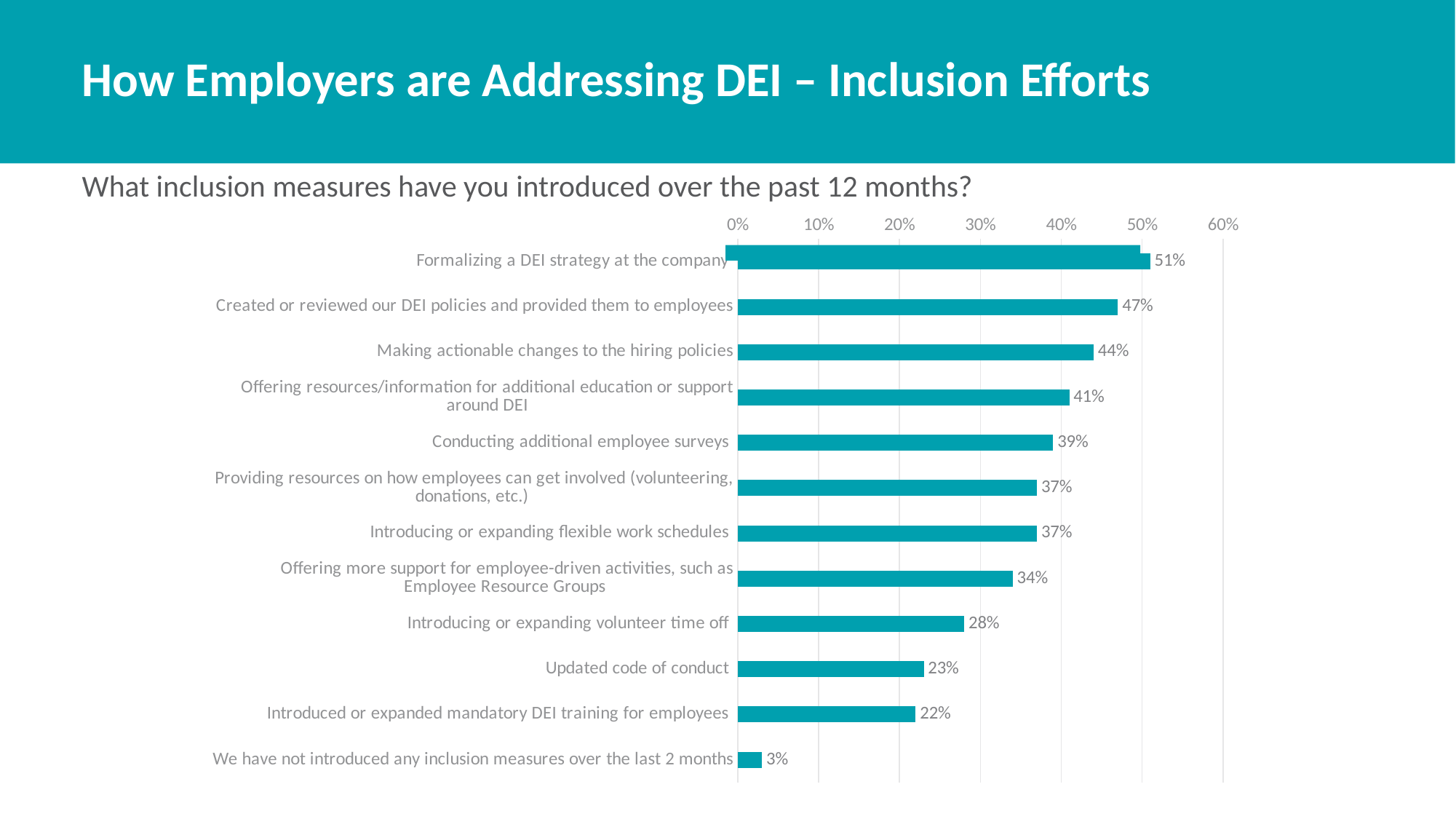
What is the difference between 'Created or reviewed our DEI policies and provided them to employees' and 'Making actionable changes to the hiring policies'? 3% What percentage of employers introduced or expanded mandatory DEI training for employees? 22% What is the value for 'Updated code of conduct'? 23% What percentage of employers reported formalizing a DEI strategy at the company? 51% What is the difference between the highest value and the lowest value in the chart? 48% What question is the chart answering, as shown above it? What inclusion measures have you introduced over the past 12 months? What kind of chart is shown on the slide? Bar chart How many categories are shown in the chart? 12 Which is larger: 'Conducting additional employee surveys' or 'Introducing or expanding volunteer time off'? Conducting additional employee surveys Which category has the lowest percentage? We have not introduced any inclusion measures over the last 2 months Which inclusion measure has the highest percentage? Formalizing a DEI strategy at the company Is the value for 'Offering more support for employee-driven activities, such as Employee Resource Groups' greater or less than 30%? greater